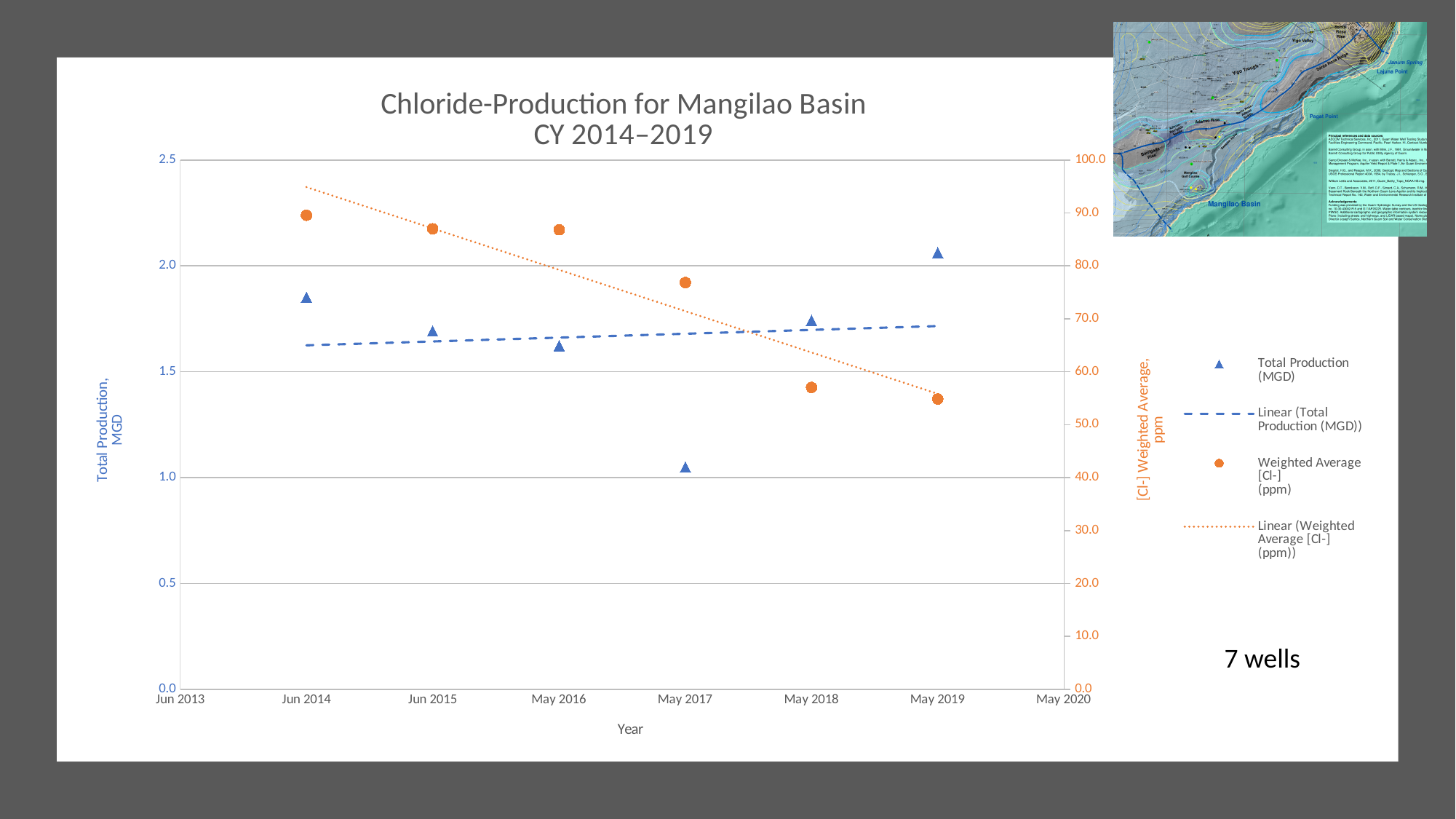
Is the Weighted Average [Cl-] (ppm) value for Jun 2014 greater or less than 80.0? greater What kind of chart is shown on the slide? Scatter chart Which is larger, Total Production (MGD) in Jun 2014 or in May 2016? Jun 2014 How many Total Production (MGD) data points are plotted on the chart? 6 At which date is Total Production (MGD) highest? May 2019 Is the Total Production (MGD) value for May 2017 greater or less than 1.5? less How many entries does the chart legend list? 4 Does the linear trendline for Weighted Average [Cl-] (ppm) rise or fall from 2014 to 2019? Fall Is the Weighted Average [Cl-] (ppm) value for May 2018 greater or less than 60.0? less At which date is Total Production (MGD) lowest? May 2017 At which date is the Weighted Average [Cl-] (ppm) highest? Jun 2014 What is the title of the chart? Chloride-Production for Mangilao Basin CY 2014–2019